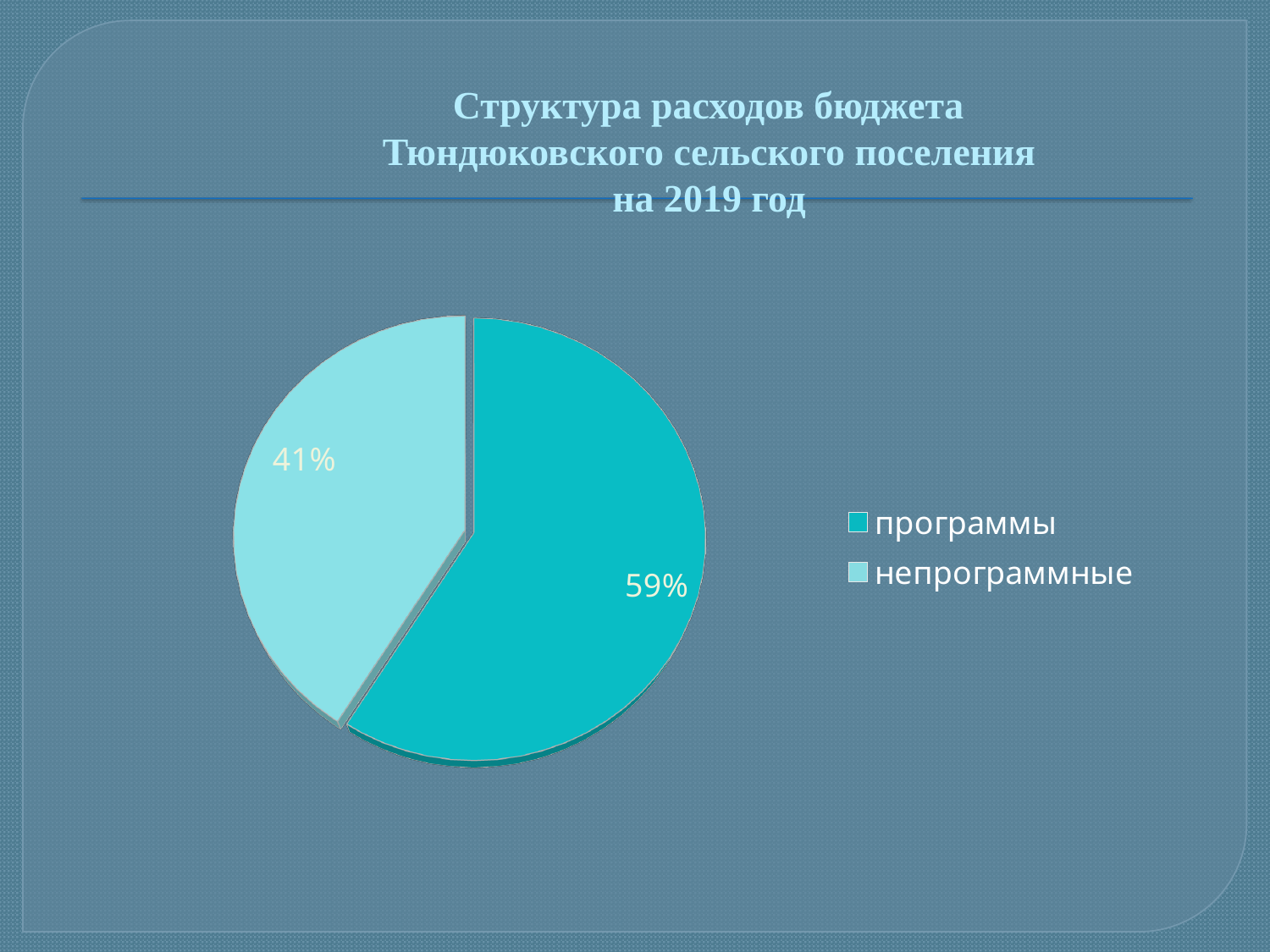
How many slices does the pie chart have? 2 Which is larger, "программы" or "непрограммные"? программы What share of the pie does "программы" take? 59% Which slice is the smallest? непрограммные Which legend entry is shown in the lighter colour? непрограммные What kind of chart is shown on the slide? pie chart How many entries does the legend list? 2 Which slice is the largest? программы What share of the pie does "непрограммные" take? 41% What is the title of the chart on the slide? Структура расходов бюджета Тюндюковского сельского поселения на 2019 год What is the difference in percentage points between "программы" and "непрограммные"? 18